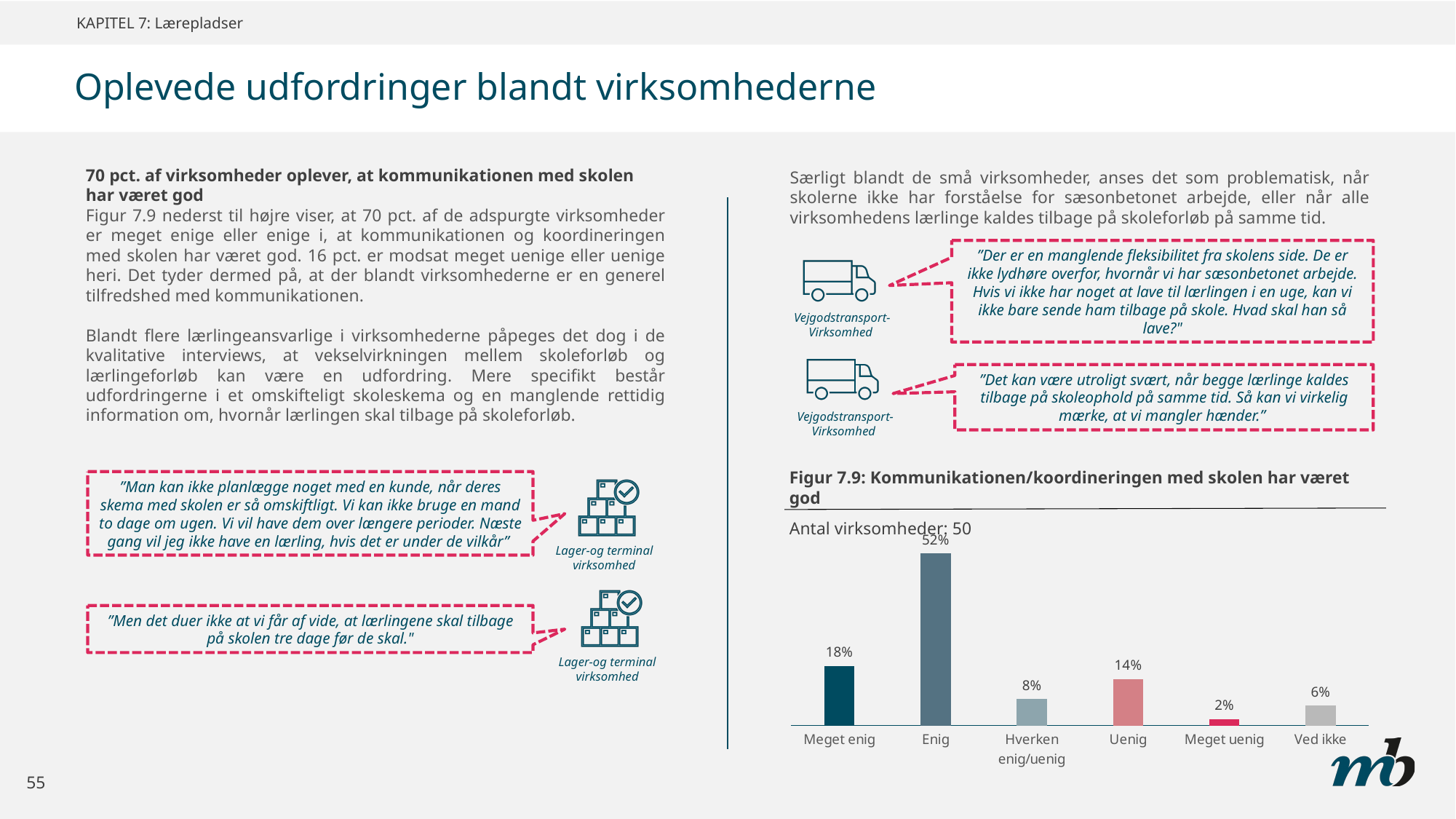
How many companies (Antal virksomheder) does the chart state it is based on? 50 What kind of chart is Figur 7.9? Bar chart Which is larger, the value for "Meget enig" or the value for "Uenig"? Meget enig What is the value for "Meget enig" in the chart? 18% Which category has the lowest value in the chart? Meget uenig What is the difference between the values for "Uenig" and "Meget uenig"? 12% What is the value for "Ved ikke" in the chart? 6% What is the difference between the values for "Enig" and "Meget enig"? 34% How many categories are shown on the x axis of the chart? 6 What is the value for "Hverken enig/uenig" in the chart? 8% Which category has the highest value in the chart? Enig What is the value for "Enig" in the chart? 52%